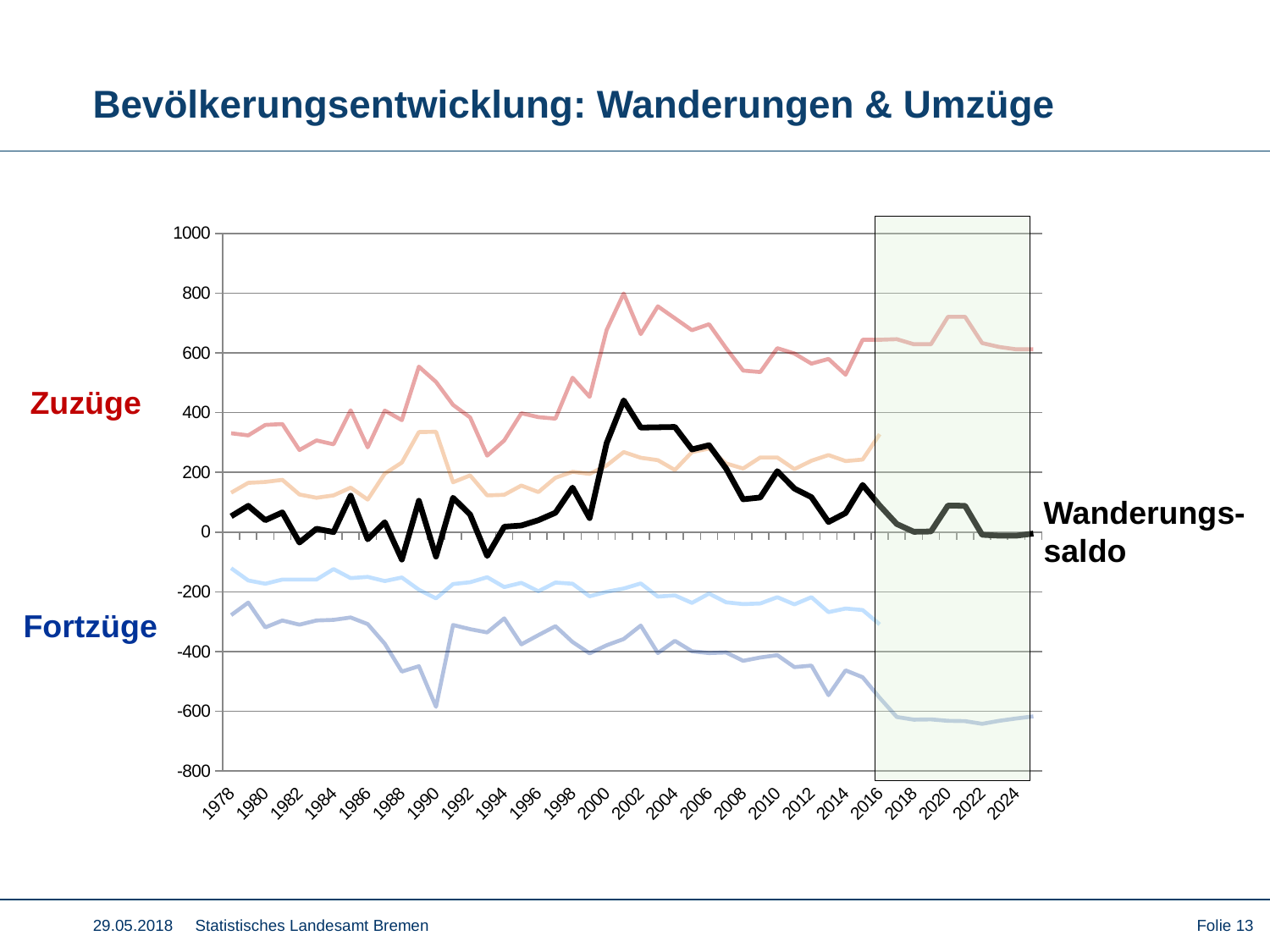
What is the last year shown on the x axis? 2024 What kind of chart is shown on the slide? line chart What is the title of the slide containing the chart? Bevölkerungsentwicklung: Wanderungen & Umzüge Do the Fortzüge lines generally rise or fall from 1978 to 2024? fall What is the highest value shown on the y axis? 1000 In which year does the upper red Zuzüge line reach its highest value? 2001 What label is given to the black line in the chart? Wanderungssaldo Is the value of the upper red Zuzüge line in 1978 greater or less than 200? greater Is the value of the Wanderungssaldo (black line) in 2016 greater or less than 0? greater What is the first year shown on the x axis? 1978 How many lines are plotted in the chart? 5 Is the value of the lower Fortzüge line in 1990 greater or less than -400? less